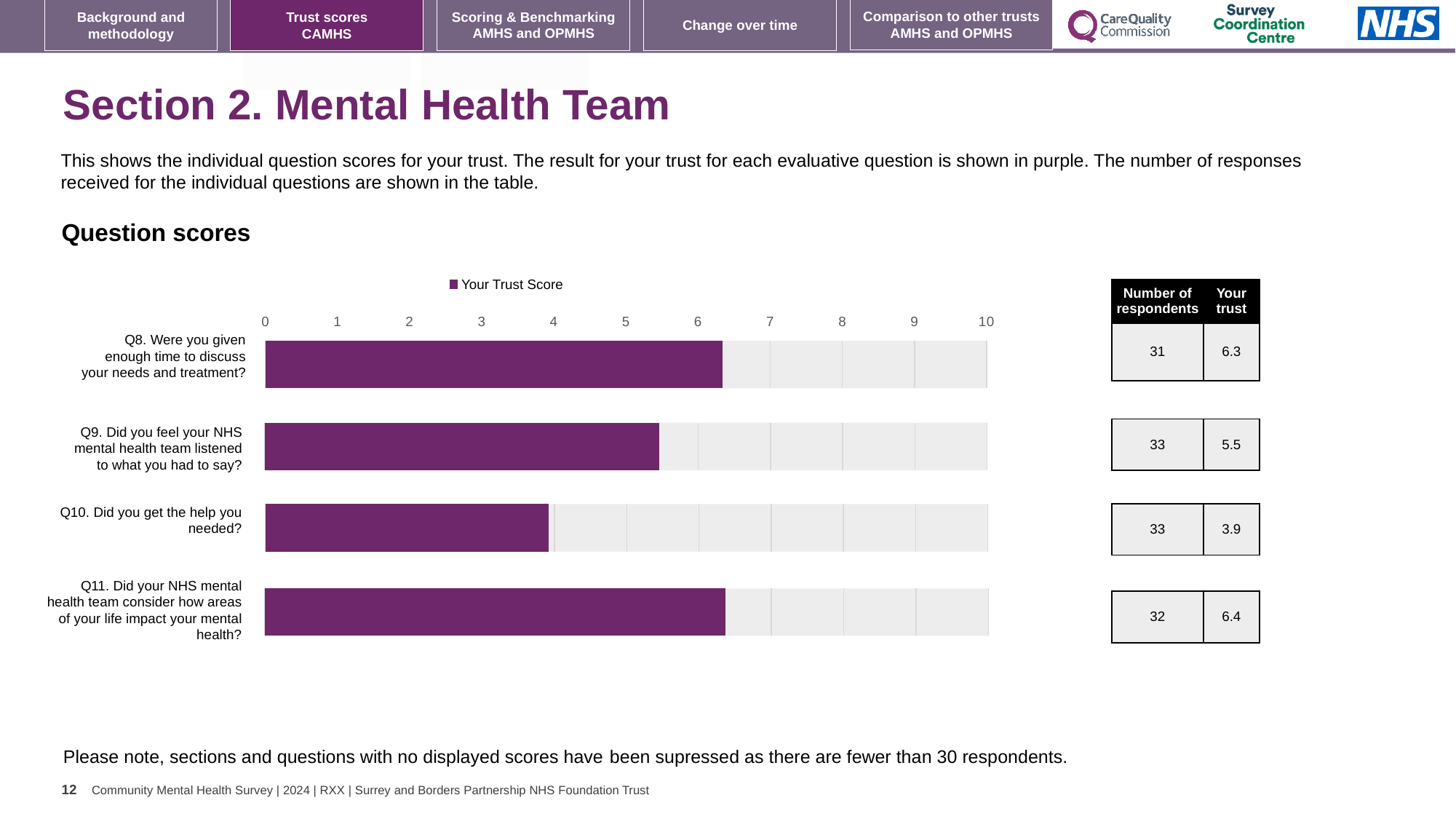
What is the name of the series shown in the chart legend? Your Trust Score What is the trust score for Q8 (Were you given enough time to discuss your needs and treatment?)? 6.3 What is the trust score for Q9 (Did you feel your NHS mental health team listened to what you had to say?)? 5.5 What is the difference between the trust scores for Q8 and Q10? 2.4 How many respondents answered Q11 according to the table? 32 How many questions are plotted in the chart? 4 What is the trust score for Q10 (Did you get the help you needed?)? 3.9 Is the trust score for Q10 greater or less than 5? less What type of chart is shown on the slide? bar chart How many series does the chart legend list? 1 Which has the larger trust score, Q9 or Q10? Q9 Which question has the lowest trust score? Q10